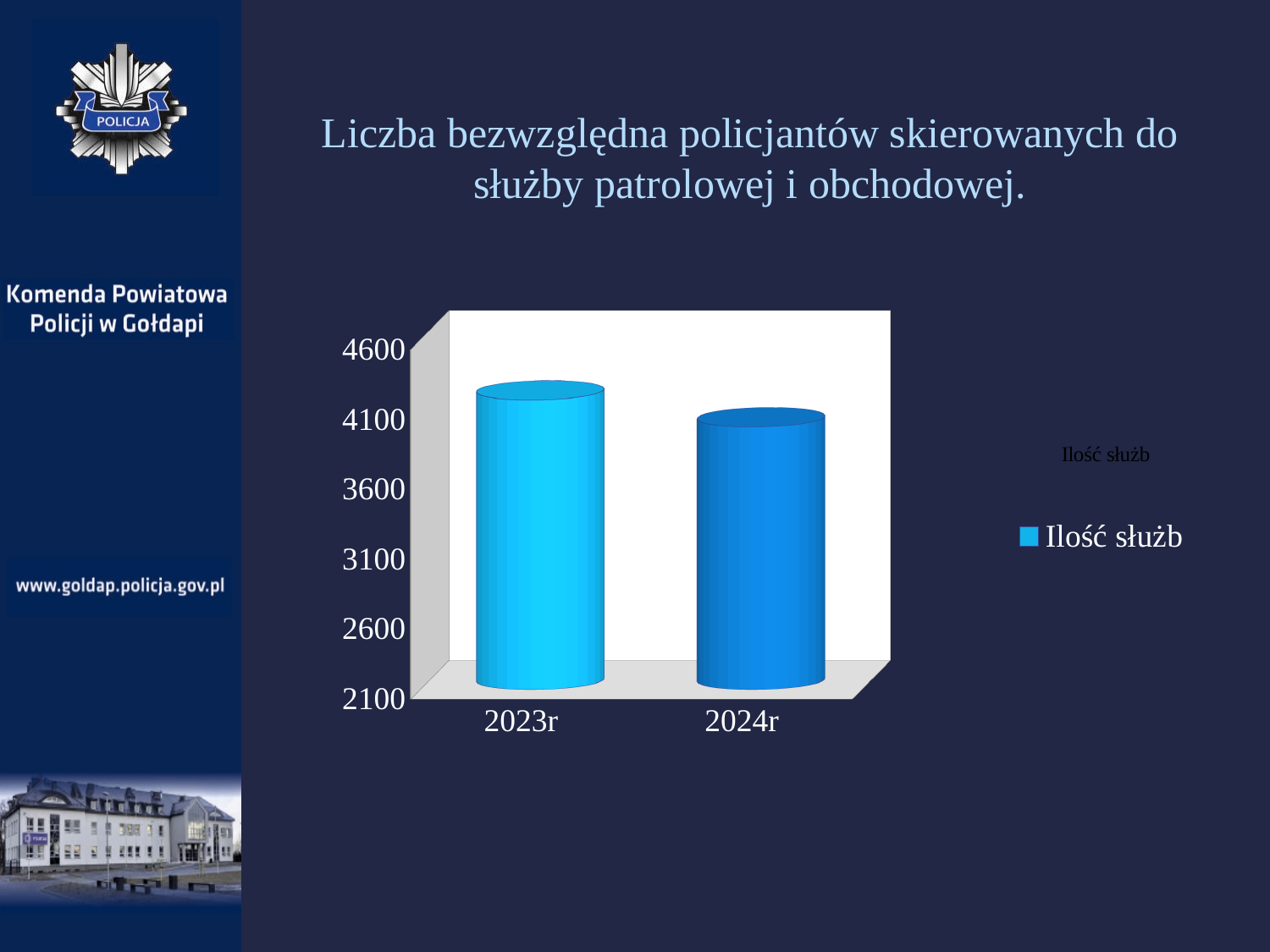
Which year has the lowest value in the chart? 2024r What is the name of the series shown in the chart legend? Ilość służb How many categories are shown on the x axis of the chart? 2 Is the value for 2023r greater or less than 4100? greater Do the values rise or fall from 2023r to 2024r? fall What is the title of the chart on the slide? Liczba bezwzględna policjantów skierowanych do służby patrolowej i obchodowej. Which is larger, the value for 2023r or the value for 2024r? 2023r What kind of chart is shown on the slide? bar chart Is the value for 2023r greater or less than 4600? less Which year has the highest value in the chart? 2023r Is the value for 2024r greater or less than 3600? greater How many series does the chart legend list? 1